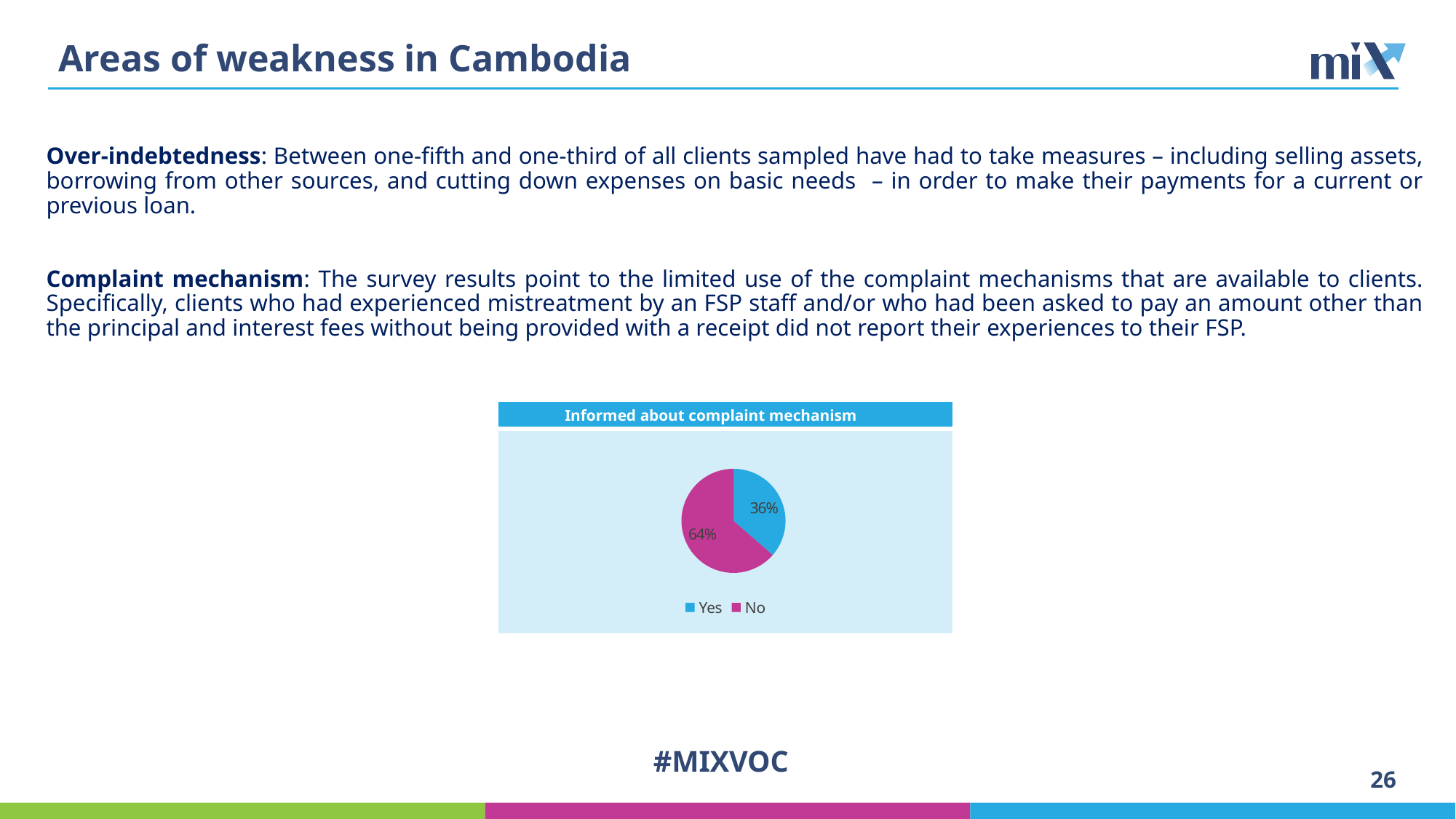
What colour is the Yes slice? blue What percentage of clients answered Yes to being informed about the complaint mechanism? 36% How many slices does the pie chart have? 2 Which slice of the pie is the largest? No Which slice of the pie is the smallest? Yes What is the difference in percentage points between the No and Yes slices? 28 What percentage of clients answered No to being informed about the complaint mechanism? 64% What share of the pie does the No slice represent? 64% What kind of chart is shown on the slide? pie chart Which is larger, the Yes slice or the No slice? No What is the title of the chart? Informed about complaint mechanism How many entries does the legend list? 2